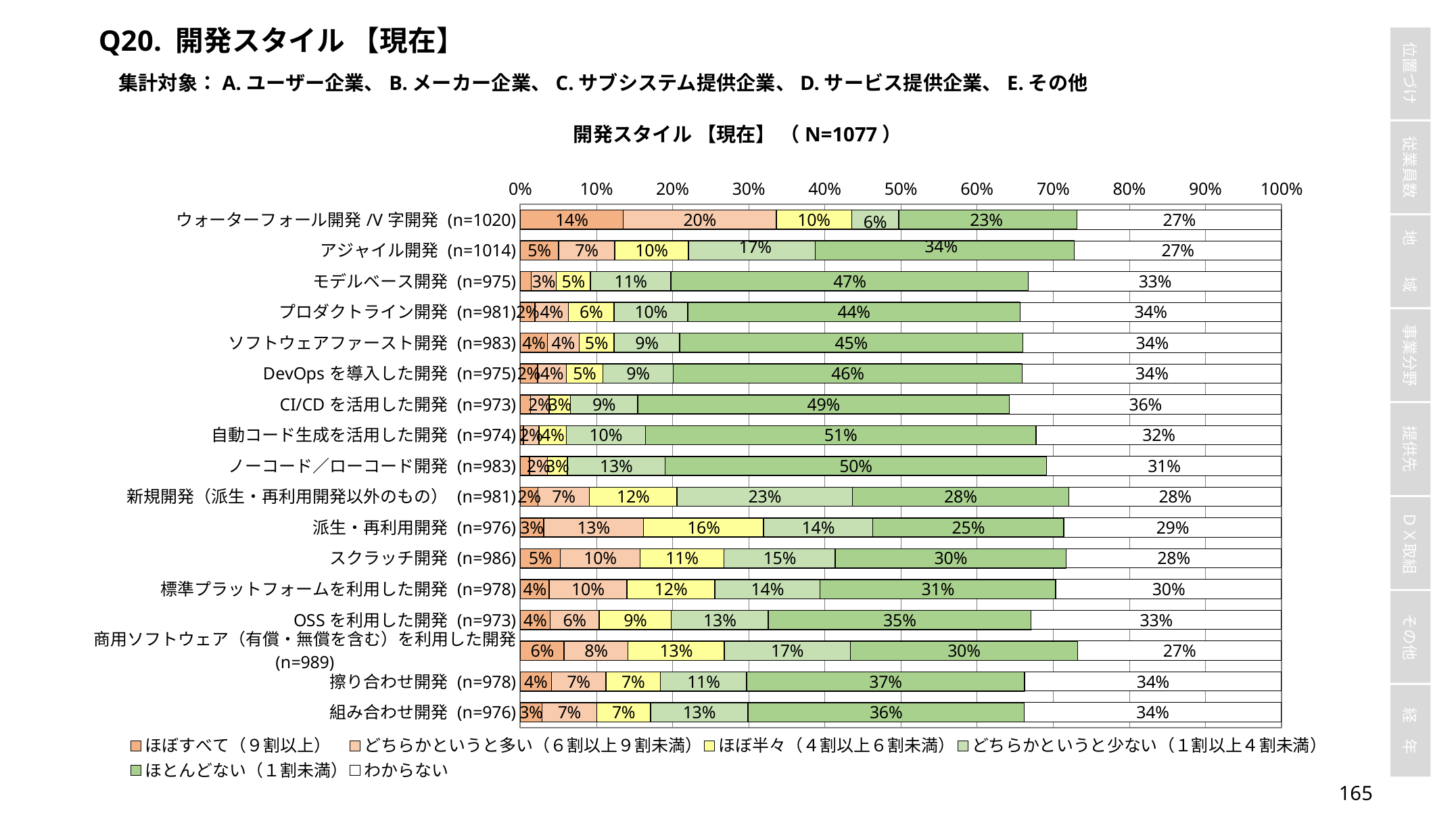
What is the value of ほぼ半々（４割以上６割未満） for 商用ソフトウェア（有償・無償を含む）を利用した開発? 13% How many development styles (categories) are shown in the chart? 17 Which development style has the highest value for ほぼすべて（９割以上）? ウォーターフォール開発 /V 字開発 Which development style has the highest value for ほとんどない（１割未満）? 自動コード生成を活用した開発 What is the value of ほぼすべて（９割以上） for ウォーターフォール開発 /V 字開発? 14% How many series does the legend list? 6 Which has a larger ほぼ半々（４割以上６割未満） value: 派生・再利用開発 or スクラッチ開発? 派生・再利用開発 What is the difference between the わからない value for CI/CD を活用した開発 and for ウォーターフォール開発 /V 字開発? 9 percentage points What is the value of ほとんどない（１割未満） for モデルベース開発? 47% What kind of chart is shown on the slide? Stacked bar chart What is the value of ほとんどない（１割未満） for アジャイル開発? 34% Which development style has the highest value for わからない? CI/CD を活用した開発